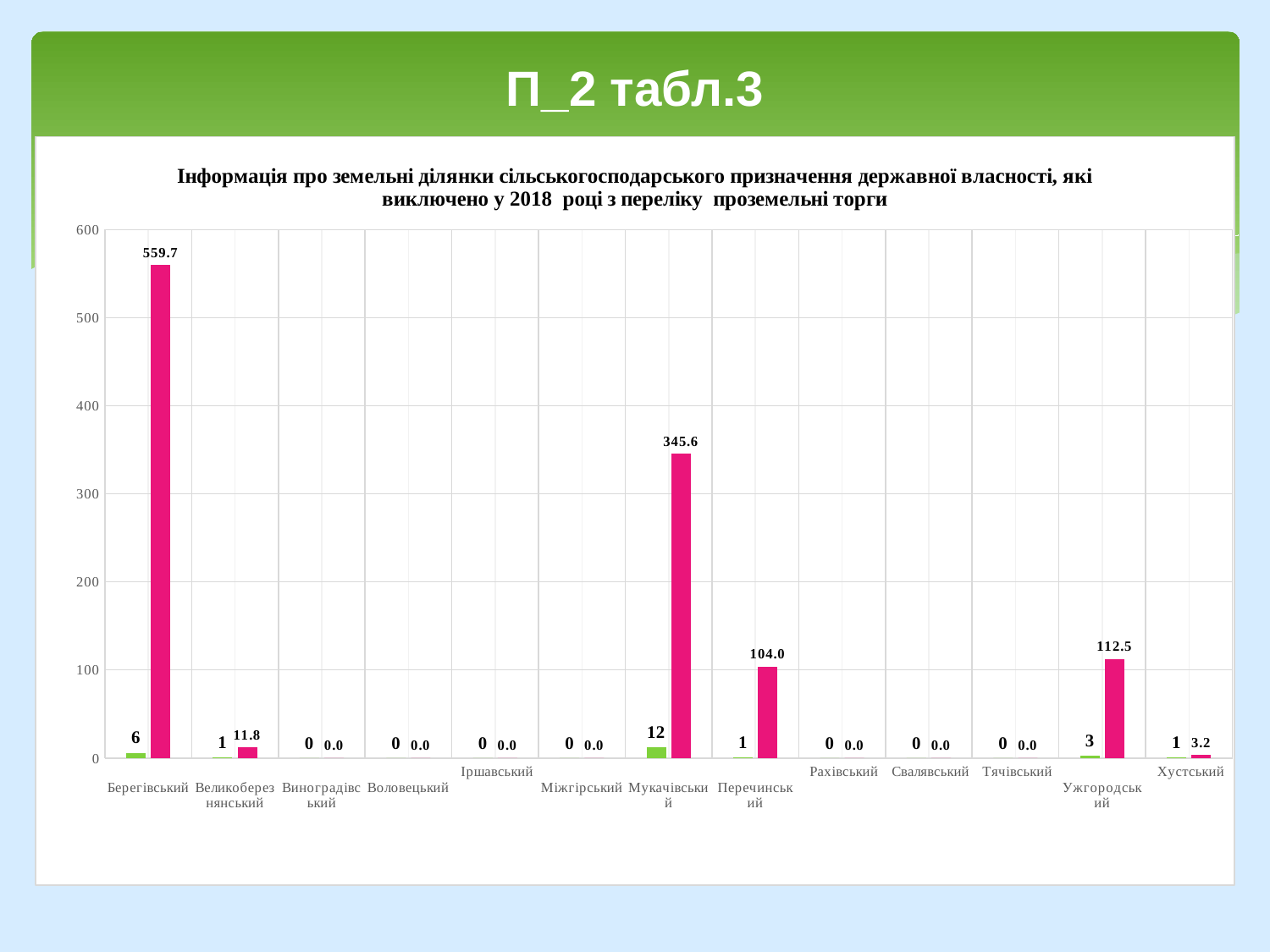
What is the value of the pink bar for Берегівський? 559.7 What is the value of the pink bar for Ужгородський? 112.5 Is the pink bar value for Мукачівський greater or less than 300? greater How many categories are shown on the x axis? 13 What kind of chart is shown on the slide? Bar chart What is the value of the pink bar for Мукачівський? 345.6 What is the difference between the pink bar values for Берегівський and Мукачівський? 214.1 Which category has the highest green bar? Мукачівський Which has a larger pink bar value, Перечинський or Ужгородський? Ужгородський Which category has the highest pink bar? Берегівський What is the value of the pink bar for Хустський? 3.2 What is the value of the green bar for Мукачівський? 12